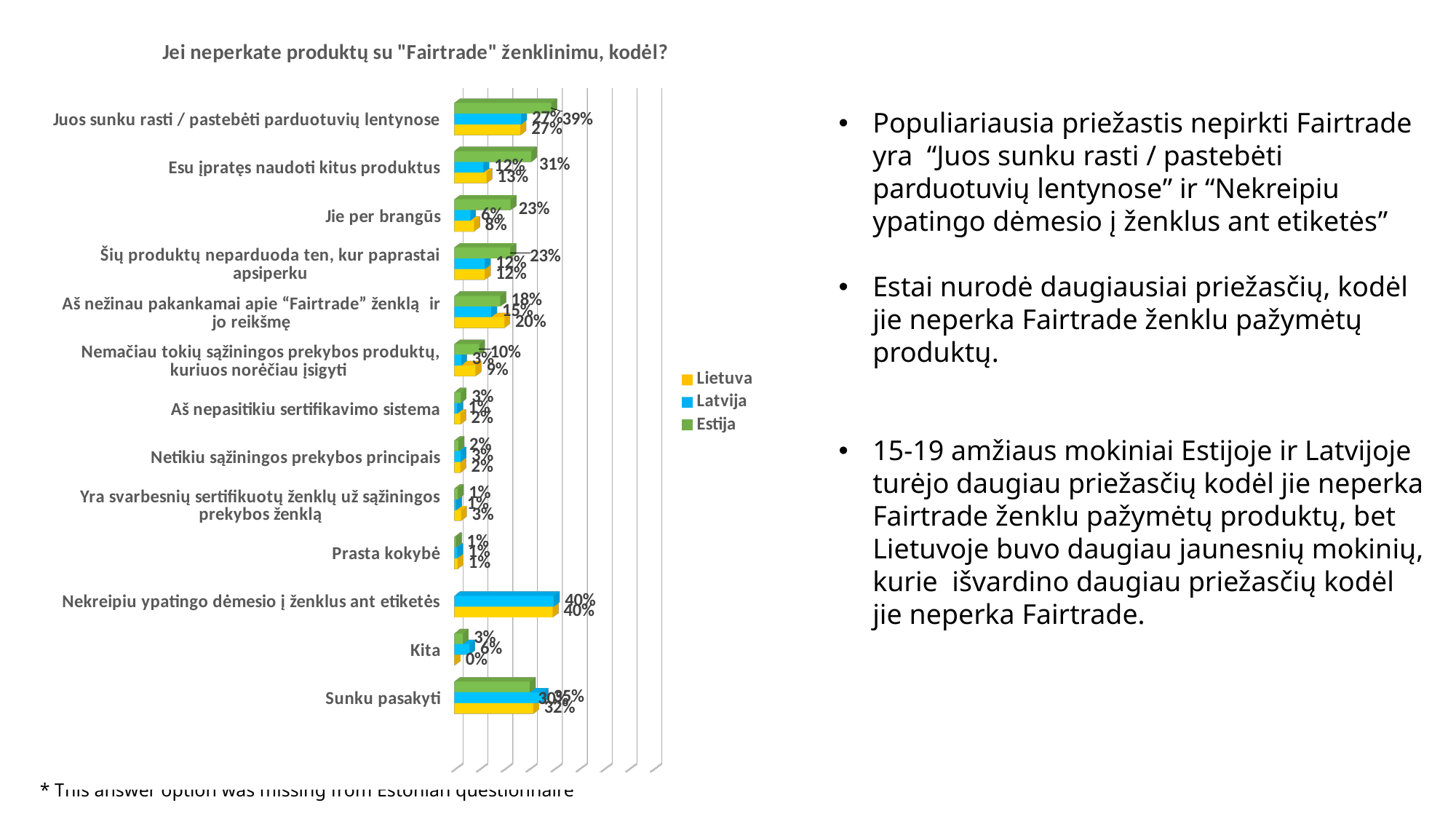
What is the Lietuva value for "Nekreipiu ypatingo dėmesio į ženklus ant etiketės"? 40% How many categories (reasons) are listed on the chart's vertical axis? 13 What is the Lietuva value for "Kita"? 0% For "Jie per brangūs", what is the difference between the Estija value and the Latvija value? 17 percentage points What is the Estija value for "Esu įpratęs naudoti kitus produktus"? 31% What kind of chart is shown on the slide? Bar chart What is the title of the chart? Jei neperkate produktų su "Fairtrade" ženklinimu, kodėl? What is the Latvija value for "Jie per brangūs"? 6% How many series does the chart legend list? 3 Which category has the highest Estija value? Juos sunku rasti / pastebėti parduotuvių lentynose For "Aš nežinau pakankamai apie “Fairtrade” ženklą ir jo reikšmę", which is larger: the Lietuva value or the Latvija value? Lietuva What is the Estija value for "Juos sunku rasti / pastebėti parduotuvių lentynose"? 39%